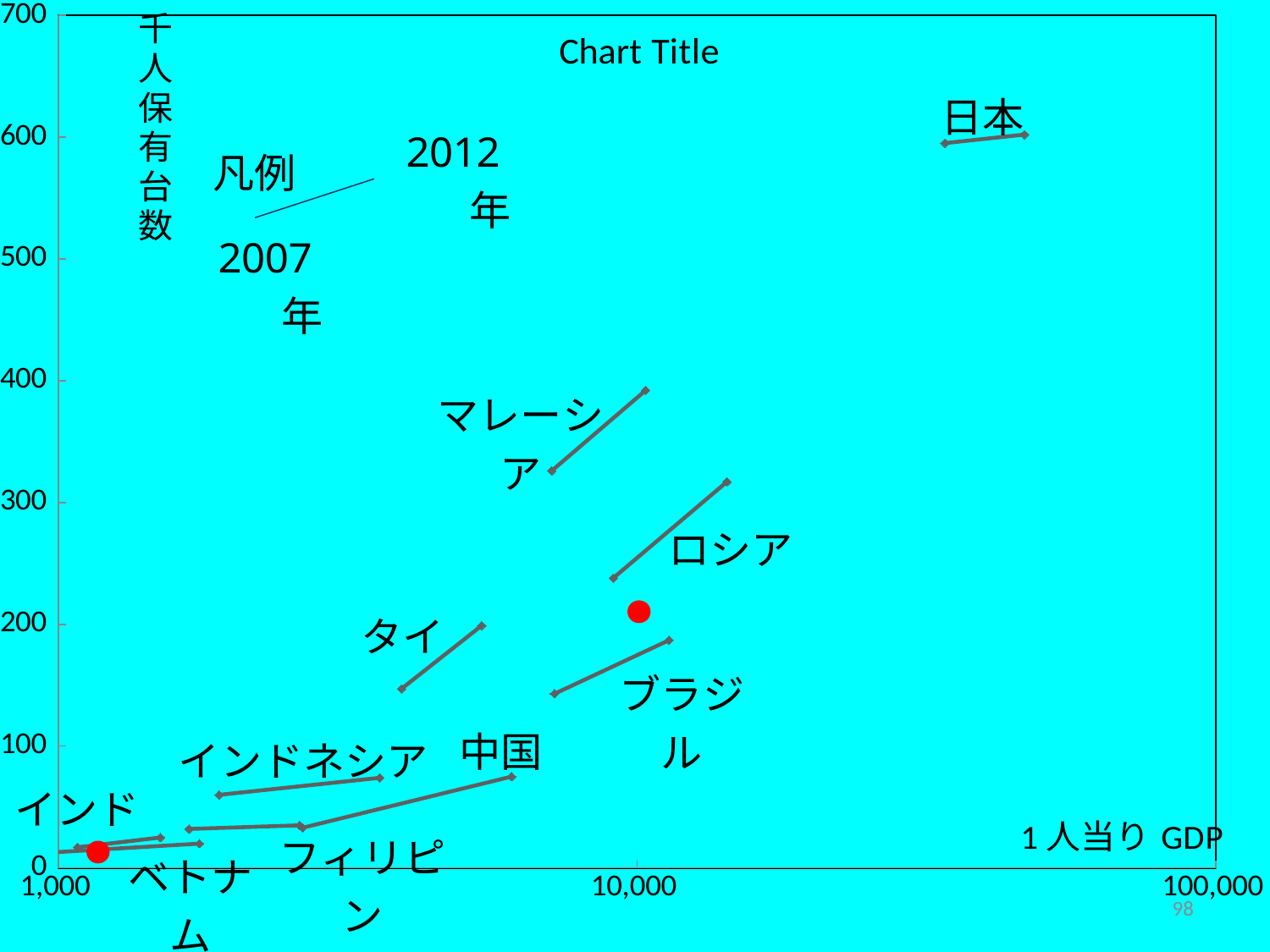
How many countries are labelled on the chart? 10 Is the value for インド greater or less than 100? less Is the value for 日本 greater or less than 500? greater Which has a higher value, 日本 or マレーシア? 日本 What is the title shown on the chart? Chart Title Is the 2012 value for 中国 greater or less than 100? less What is the label on the vertical axis of the chart? 千人保有台数 Which has a higher value, ロシア or 中国? ロシア Does the value for マレーシア rise or fall from 2007 to 2012? rise Which country has the highest value on the chart? 日本